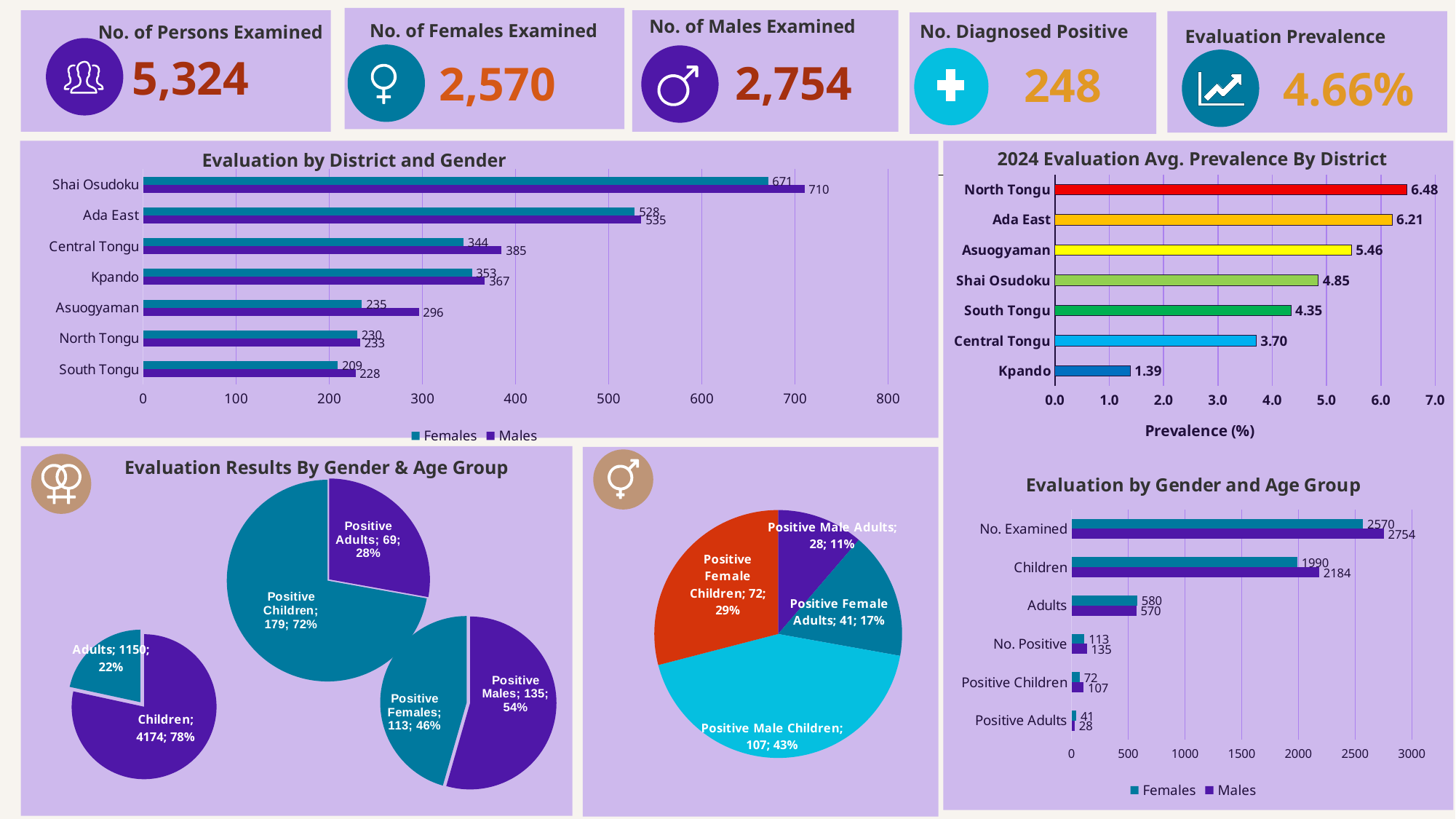
In the 'Evaluation by District and Gender' chart, what is the value for Males in Shai Osudoku? 710 In the 'Evaluation by District and Gender' chart, how many series does the legend list? 2 In the 'Evaluation by District and Gender' chart, what is the difference between the Males and Females values for Asuogyaman? 61 In the 'Evaluation by Gender and Age Group' bar chart, which is larger for Adults, Females or Males? Females In the 'Evaluation by Gender and Age Group' bar chart, what is the Females value for Children? 1990 In the pie chart at the bottom centre of the slide, what is the value for Positive Male Children? 107 In the '2024 Evaluation Avg. Prevalence By District' chart, what is the prevalence for Central Tongu? 3.70 In the 'Evaluation Results By Gender & Age Group' pies, what share of the pie is Positive Children? 72% In the '2024 Evaluation Avg. Prevalence By District' chart, which district has the lowest prevalence? Kpando What kind of chart is the '2024 Evaluation Avg. Prevalence By District' chart? bar chart In the '2024 Evaluation Avg. Prevalence By District' chart, which district has the highest prevalence? North Tongu In the '2024 Evaluation Avg. Prevalence By District' chart, how many districts are shown? 7